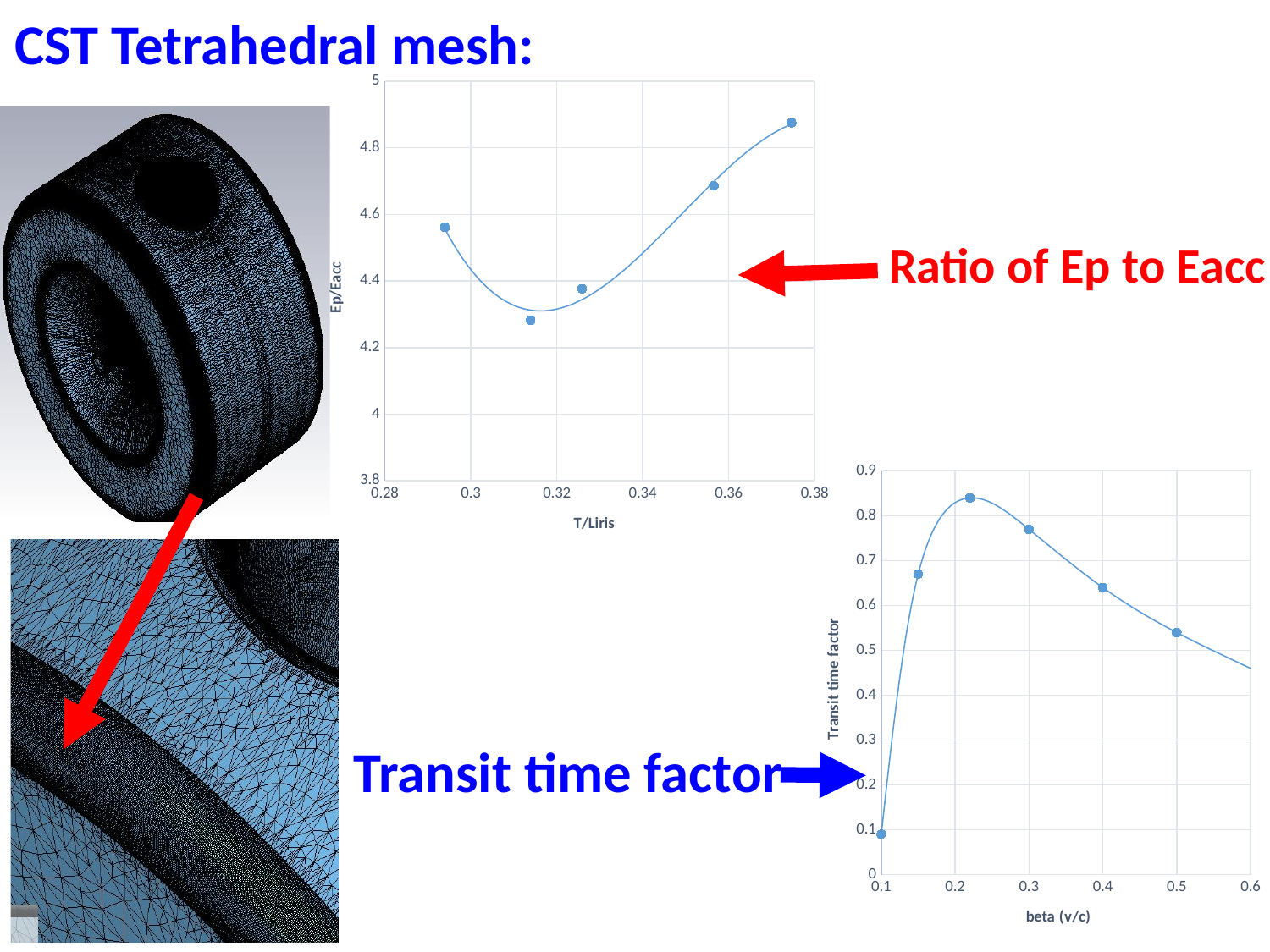
In the bottom chart, is the transit time factor at beta 0.1 greater or less than 0.2? less In the top chart, is the Ep/Eacc value of the lowest point greater or less than 4.4? less What kind of chart is the top chart showing Ep/Eacc against T/Liris? Scatter chart with a smoothed line In the bottom chart, is the transit time factor at beta 0.5 greater or less than 0.6? less What is the x-axis label of the bottom chart? beta (v/c) In the top chart (Ep/Eacc vs T/Liris), how many data points are plotted? 5 In the bottom chart, how does the transit time factor change as beta increases from 0.1 to 0.6? It rises sharply to a peak near beta 0.2, then falls In the top chart, which point has the highest Ep/Eacc value: the leftmost point or the rightmost point? The rightmost point